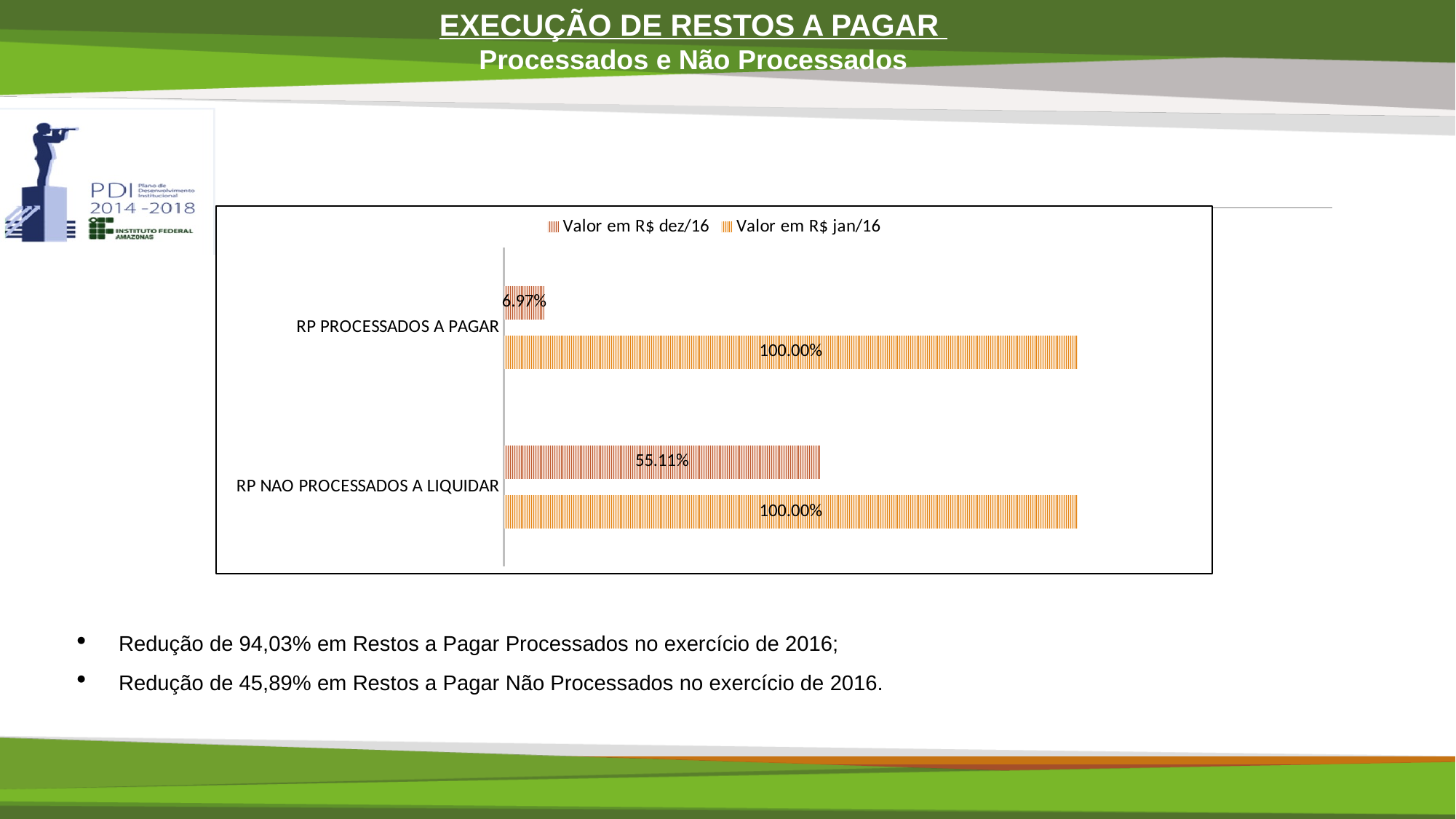
How many categories are shown in the chart? 2 How many series does the legend list? 2 What is the value for RP PROCESSADOS A PAGAR in the Valor em R$ dez/16 series? 6.97% What is the difference between the Valor em R$ jan/16 and Valor em R$ dez/16 values for RP PROCESSADOS A PAGAR? 93.03% What is the difference between the Valor em R$ dez/16 values for RP NAO PROCESSADOS A LIQUIDAR and RP PROCESSADOS A PAGAR? 48.14% Which category has the lowest value in the Valor em R$ dez/16 series? RP PROCESSADOS A PAGAR What is the value for RP NAO PROCESSADOS A LIQUIDAR in the Valor em R$ dez/16 series? 55.11% What is the value for RP NAO PROCESSADOS A LIQUIDAR in the Valor em R$ jan/16 series? 100.00% Which category has the highest value in the Valor em R$ dez/16 series? RP NAO PROCESSADOS A LIQUIDAR What kind of chart is shown on the slide? Bar chart What is the value for RP PROCESSADOS A PAGAR in the Valor em R$ jan/16 series? 100.00% For RP NAO PROCESSADOS A LIQUIDAR, which series has the larger value, Valor em R$ dez/16 or Valor em R$ jan/16? Valor em R$ jan/16